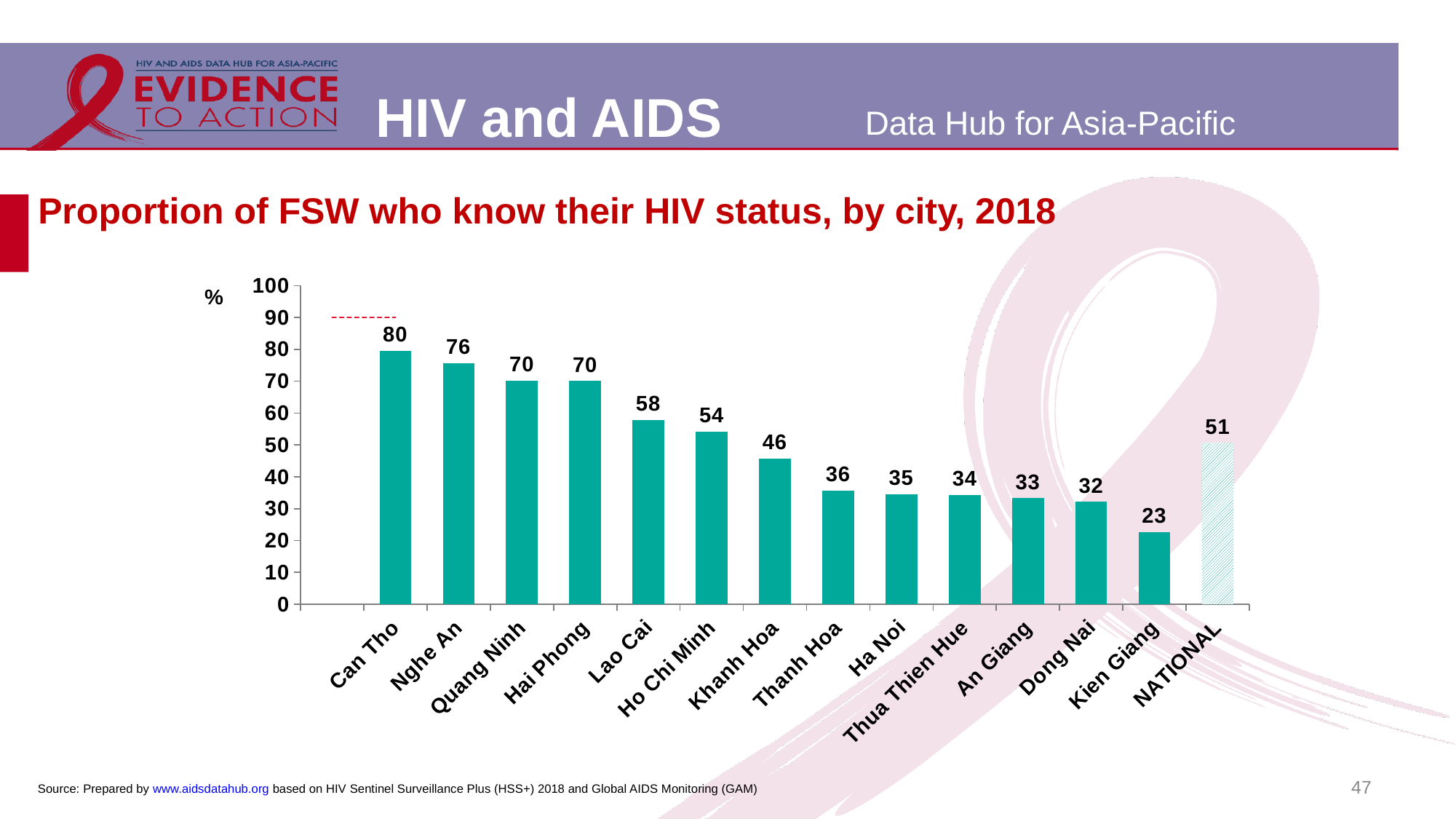
What is the value for Can Tho? 80 Which city has the lowest proportion of FSW who know their HIV status? Kien Giang What is the value for Ho Chi Minh? 54 What kind of chart is shown on the slide? Bar chart Do the city values rise or fall from left to right along the x axis? Fall What is the title of the chart? Proportion of FSW who know their HIV status, by city, 2018 How many bars are shown in the chart, including NATIONAL? 14 Which is larger, the value for Lao Cai or the value for Khanh Hoa? Lao Cai What is the difference between the values for Can Tho and Kien Giang? 57 Which city has the highest proportion of FSW who know their HIV status? Can Tho What is the NATIONAL value? 51 Is the value for Nghe An greater or less than 70? greater